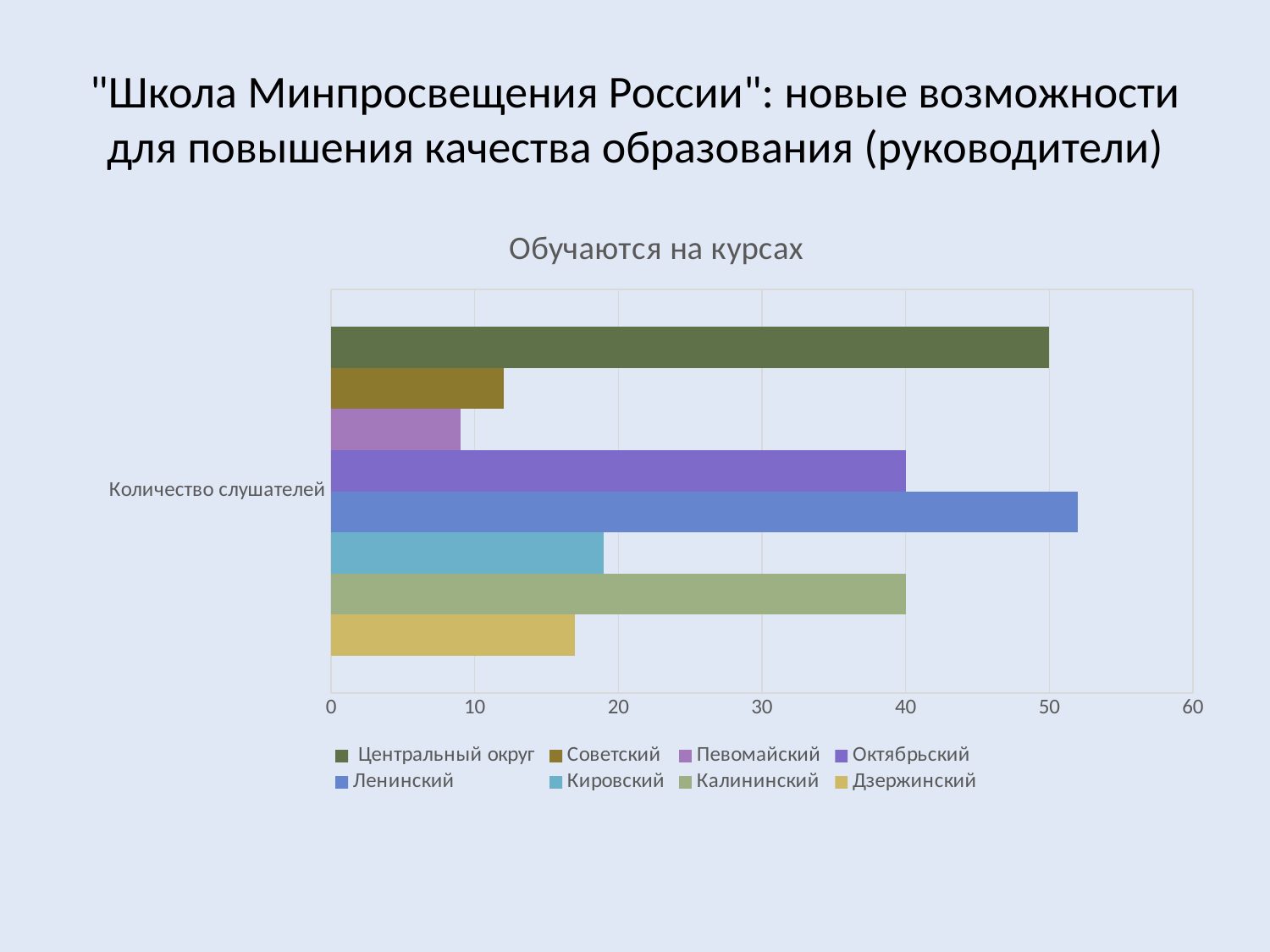
What is the category label shown on the vertical axis? Количество слушателей Which series has the lowest value? Певомайский What kind of chart is shown on the slide? bar chart What is the value for Центральный округ? 50 What is the title of the chart? Обучаются на курсах Is the value for Кировский greater or less than 20? less What is the value for Октябрьский? 40 Which is larger, the value for Кировский or the value for Советский? Кировский How many series does the legend list? 8 Which series has the highest value? Ленинский Is the value for Советский greater or less than 10? greater Is the value for Ленинский greater or less than 50? greater